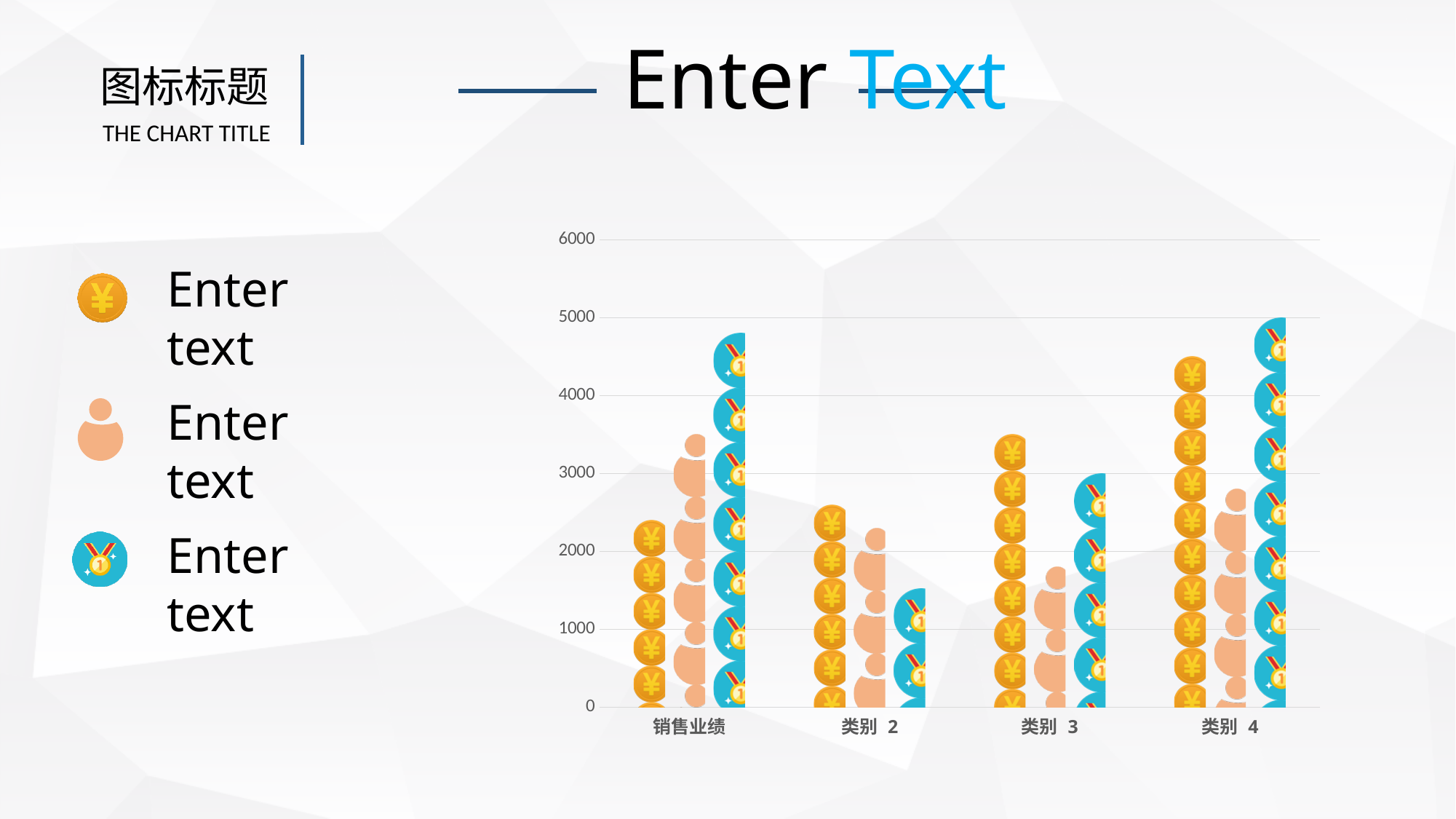
Which is larger for 类别 3: the coin-icon bar or the person-icon bar? the coin-icon bar Which category has the shortest medal-icon bar? 类别 2 Is the value of the medal-icon bar for 销售业绩 greater or less than 4000? greater Is the value of the medal-icon bar for 类别 2 greater or less than 2000? less How many bars are plotted for each category in the chart? 3 What kind of chart is shown on the slide? bar chart How many categories are shown on the x axis of the chart? 4 Is the value of the coin-icon bar for 类别 4 greater or less than 4000? greater Which category has the tallest medal-icon bar? 类别 4 What is the highest value labelled on the vertical axis of the chart? 6000